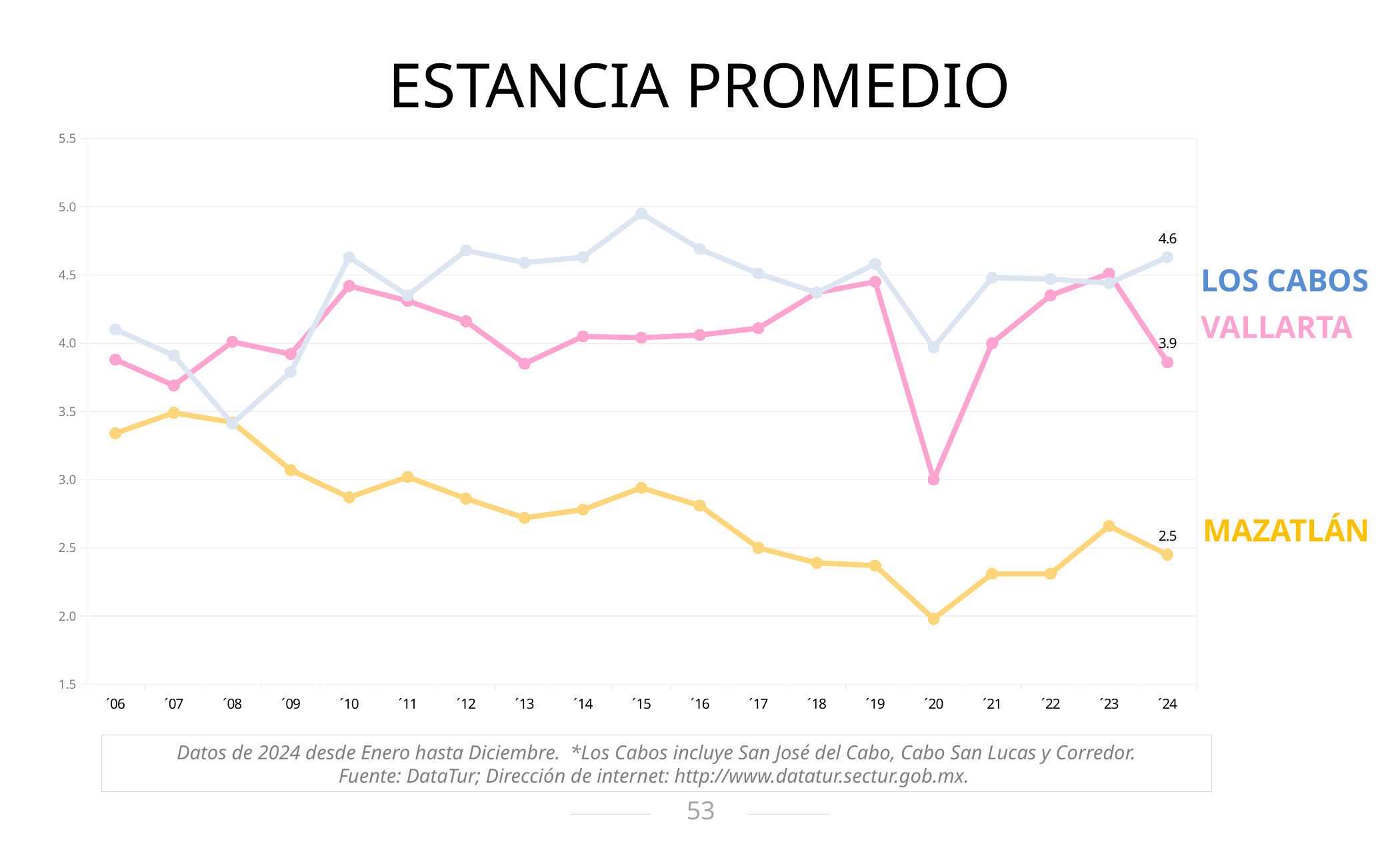
What is the value for LOS CABOS in ´24? 4.6 In which year does the MAZATLÁN series reach its lowest value? ´20 Is the value for VALLARTA in ´20 greater or less than 3.5? less Is the value for LOS CABOS in ´15 greater or less than 4.5? greater What kind of chart is shown on the slide? Line chart What is the value for VALLARTA in ´24? 3.9 In which year does the LOS CABOS series reach its highest value? ´15 What is the value for MAZATLÁN in ´24? 2.5 What is the difference between the LOS CABOS and MAZATLÁN values in ´24? 2.2 In ´24, which is larger, the value for LOS CABOS or the value for VALLARTA? LOS CABOS How many years are shown on the x axis? 19 Is the value for MAZATLÁN in ´20 greater or less than 2.5? less